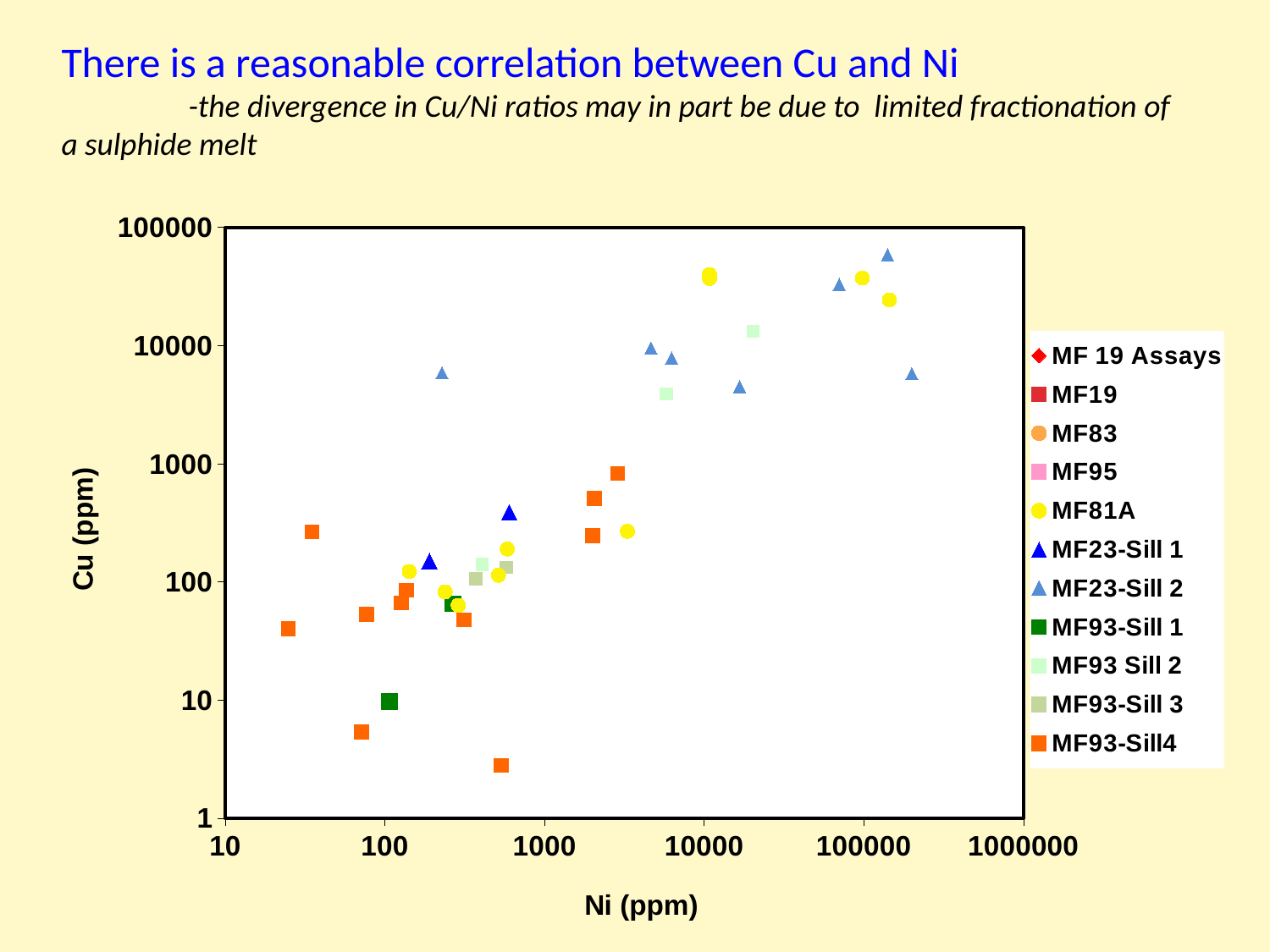
What kind of chart is shown on the slide? scatter chart Is the highest Cu value for MF23-Sill 1 greater or less than 1000? less What is the label of the x axis? Ni (ppm) Is the highest Cu value for MF81A greater or less than 10000? greater What is the first series listed in the legend? MF 19 Assays Do Cu values generally rise or fall as Ni increases along the x axis? rise How many series does the legend list? 11 Is the highest Ni value for MF23-Sill 2 greater or less than 100000? greater Which series reaches a higher Cu value, MF93-Sill4 or MF81A? MF81A Which series contains the point with the highest Cu value? MF23-Sill 2 Which series contains the point with the lowest Cu value? MF93-Sill4